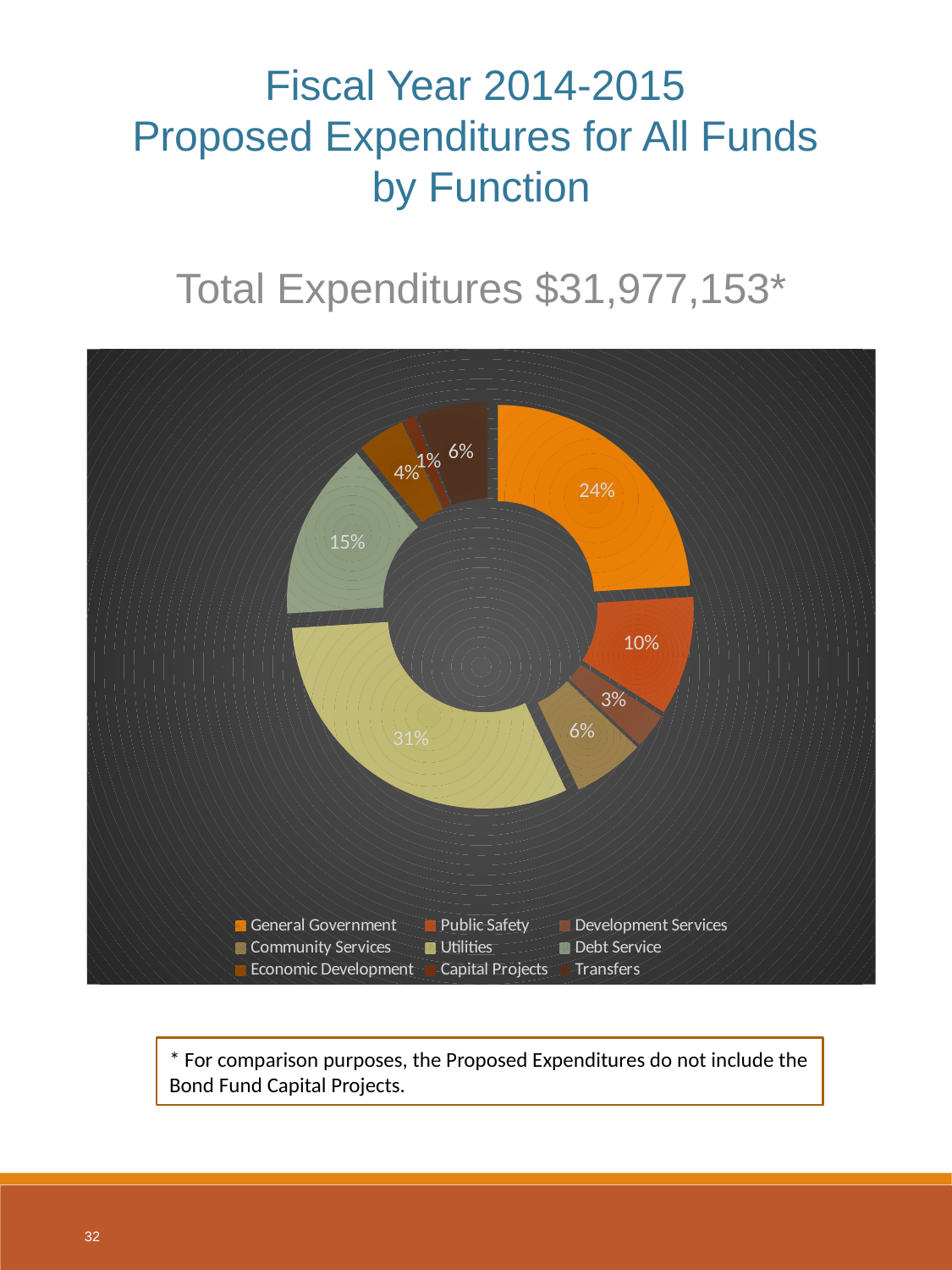
Which is larger, the share for Debt Service or the share for Public Safety? Debt Service What kind of chart is shown on the slide? Doughnut chart Which function has the smallest share of proposed expenditures? Capital Projects Which function has the largest share of proposed expenditures? Utilities How many functions are listed in the chart legend? 9 What is the combined share of Public Safety and Development Services? 13% What share does Debt Service represent? 15% What share of proposed expenditures goes to Utilities? 31% What percentage is shown for Public Safety? 10% What percentage of the chart is General Government? 24% How many percentage points larger is the Utilities share than the General Government share? 7 What is the total expenditures figure stated on the slide? $31,977,153